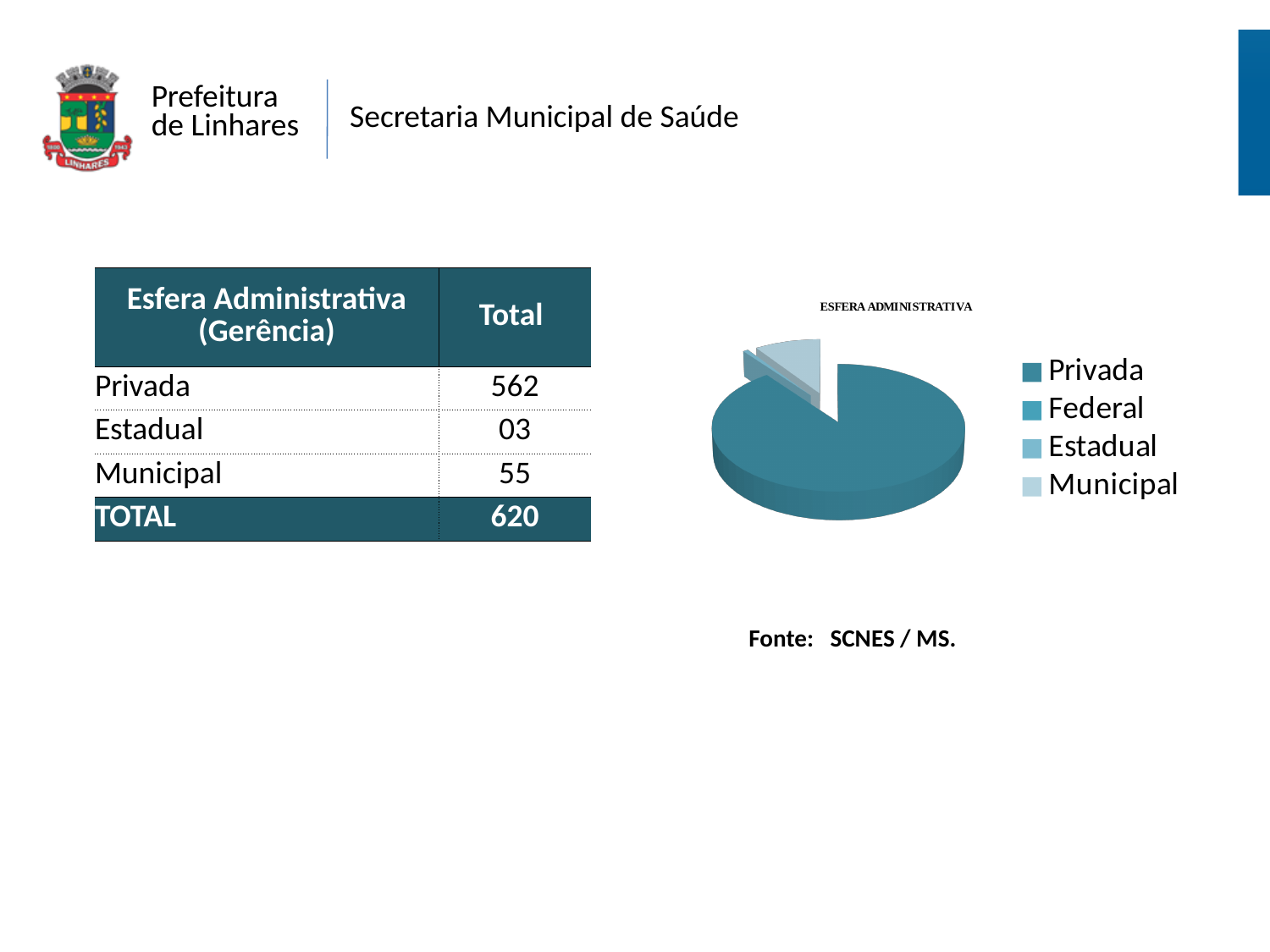
What is the title of the pie chart? ESFERA ADMINISTRATIVA Using the table values, what is the difference between Municipal and Estadual? 52 What kind of chart is shown under the title ESFERA ADMINISTRATIVA? pie chart Using the table values, what is the difference between Privada and Municipal? 507 Which category takes up the largest slice of the pie chart? Privada Which category is listed second in the pie chart's legend? Federal According to the table next to the pie chart, what is the total for Estadual? 03 According to the table next to the pie chart, what is the total for Privada? 562 What is the overall TOTAL shown in the table next to the pie chart? 620 According to the table next to the pie chart, what is the total for Municipal? 55 Which is larger in the pie chart, the Municipal slice or the Estadual slice? Municipal How many entries does the legend of the pie chart list? 4